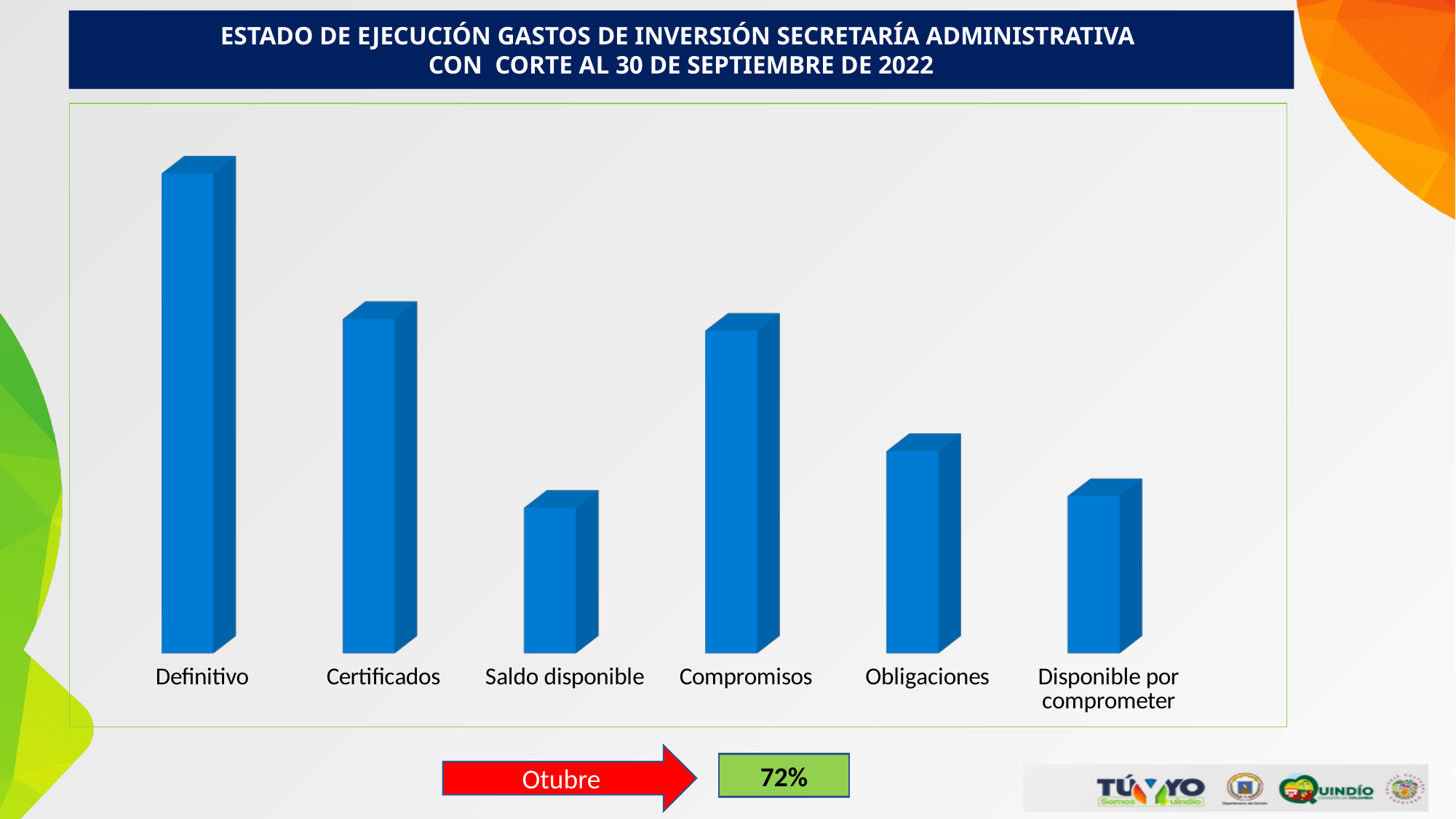
Which is larger, the value for Obligaciones or the value for Saldo disponible? Obligaciones Which category has the lowest bar? Saldo disponible How many categories are plotted in the bar chart? 6 What colour are the bars in the chart? Blue Which is larger, the value for Compromisos or the value for Obligaciones? Compromisos Which is larger, the value for Definitivo or the value for Certificados? Definitivo Which category has the highest bar? Definitivo What kind of chart is shown on the slide? Bar chart What is the title of the chart on the slide? ESTADO DE EJECUCIÓN GASTOS DE INVERSIÓN SECRETARÍA ADMINISTRATIVA CON CORTE AL 30 DE SEPTIEMBRE DE 2022